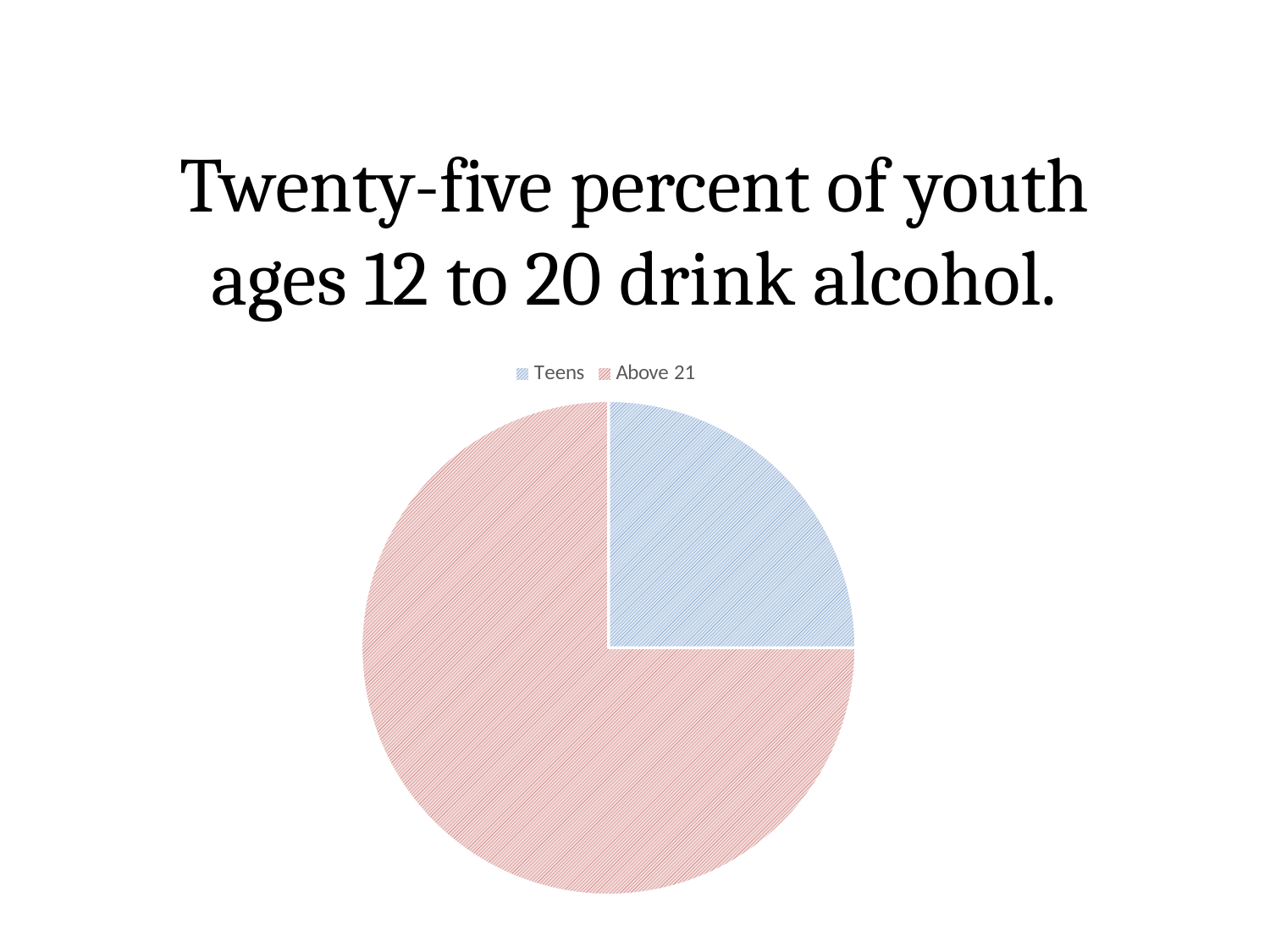
Which slice of the pie chart is the largest? Above 21 How many entries does the legend of the pie chart list? 2 Which slice is larger in the pie chart, Teens or Above 21? Above 21 What are the two categories listed in the legend of the pie chart? Teens and Above 21 How many slices does the pie chart have? 2 Which slice of the pie chart is the smallest? Teens What kind of chart is shown on the slide? pie chart Which colour represents the Teens slice in the pie chart? blue